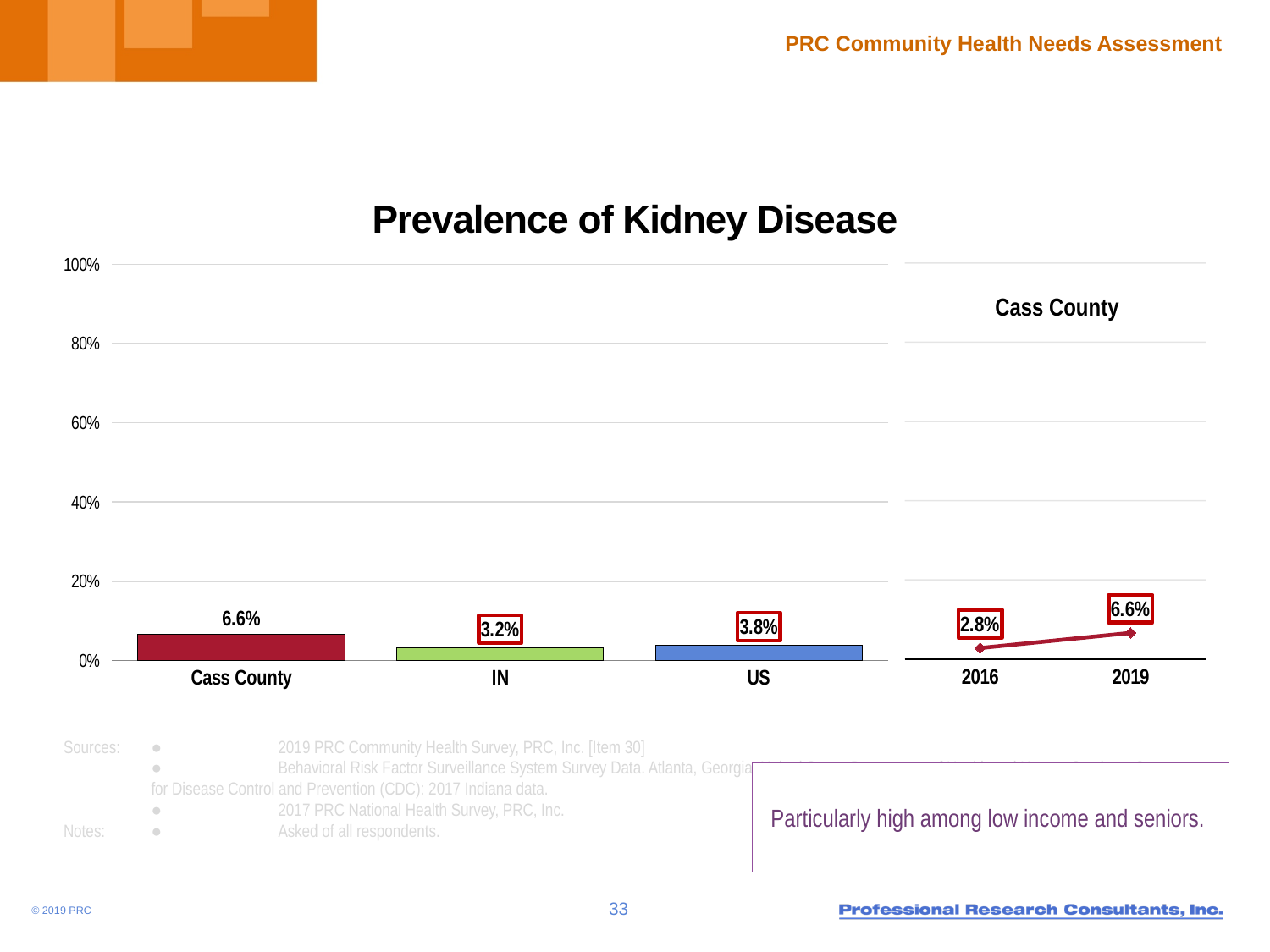
In the Cass County chart on the right, do the values rise or fall from 2016 to 2019? rise In the bar chart on the left, which category has the lowest value? IN In the bar chart on the left, which is larger, the value for IN or the value for US? US In the bar chart on the left, what is the value for Cass County? 6.6% In the bar chart on the left, what is the value for IN? 3.2% In the bar chart on the left, how many categories are shown? 3 In the bar chart on the left, which category has the highest value? Cass County In the bar chart on the left, what is the difference between the Cass County value and the US value? 2.8% In the Cass County chart on the right, what is the value for 2016? 2.8% In the bar chart on the left, what is the value for US? 3.8% What is the title of the chart on the slide? Prevalence of Kidney Disease In the Cass County chart on the right, what is the value for 2019? 6.6%